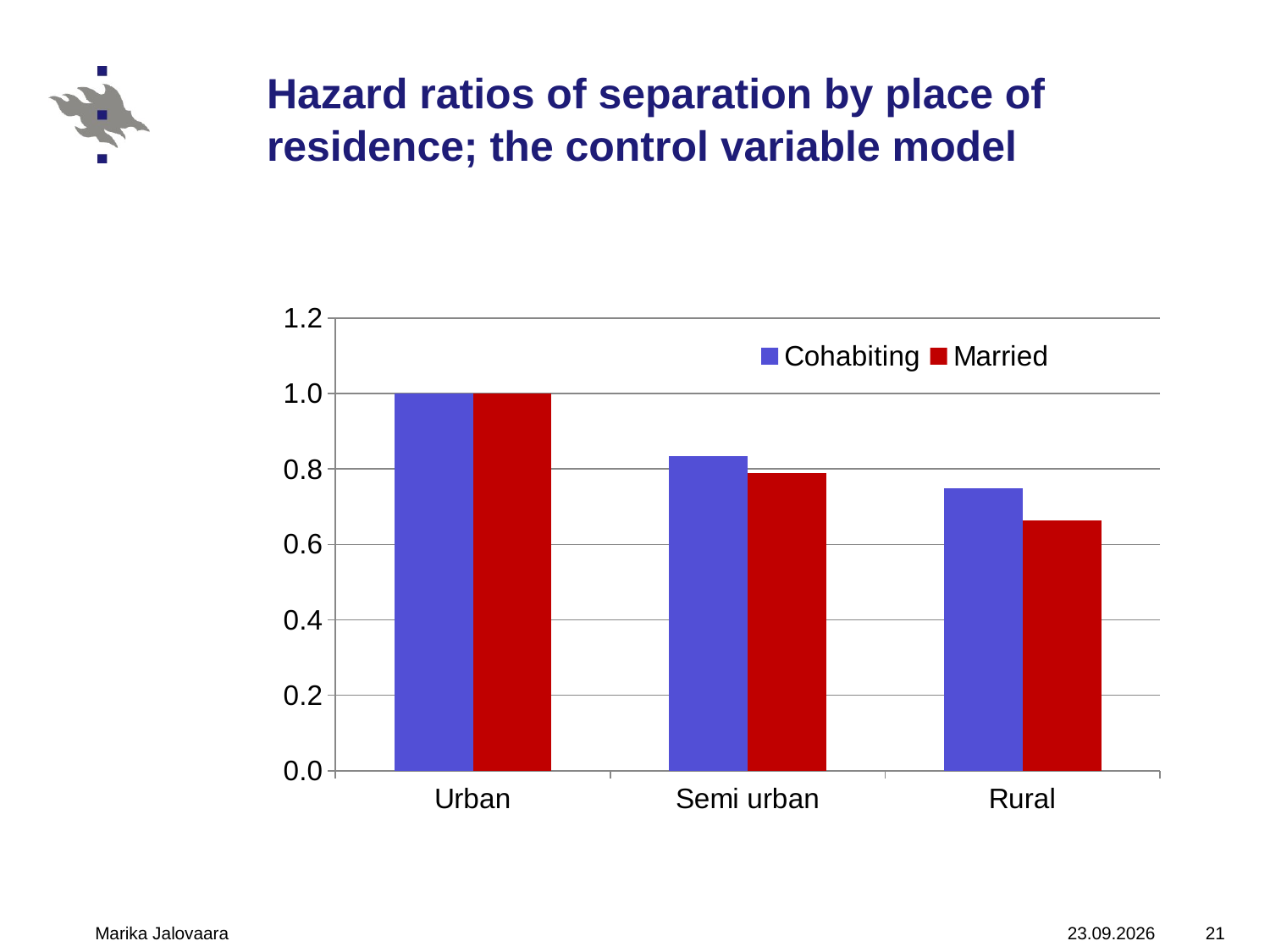
What is the hazard ratio for Married in the Urban category? 1.0 How many series does the legend list? 2 How many place-of-residence categories are shown on the x axis? 3 Is the value for Married in the Rural category greater or less than 0.8? less Do the Cohabiting values rise or fall from Urban to Rural along the x axis? fall In the Rural category, which is larger: the Cohabiting value or the Married value? Cohabiting Is the value for Cohabiting in the Semi urban category greater or less than 0.8? greater What kind of chart is shown on the slide? bar chart Is the value for Married in the Semi urban category greater or less than 0.6? greater Which colour represents the Married series in the legend? red What is the hazard ratio for Cohabiting in the Urban category? 1.0 Which category has the lowest value for the Married series? Rural